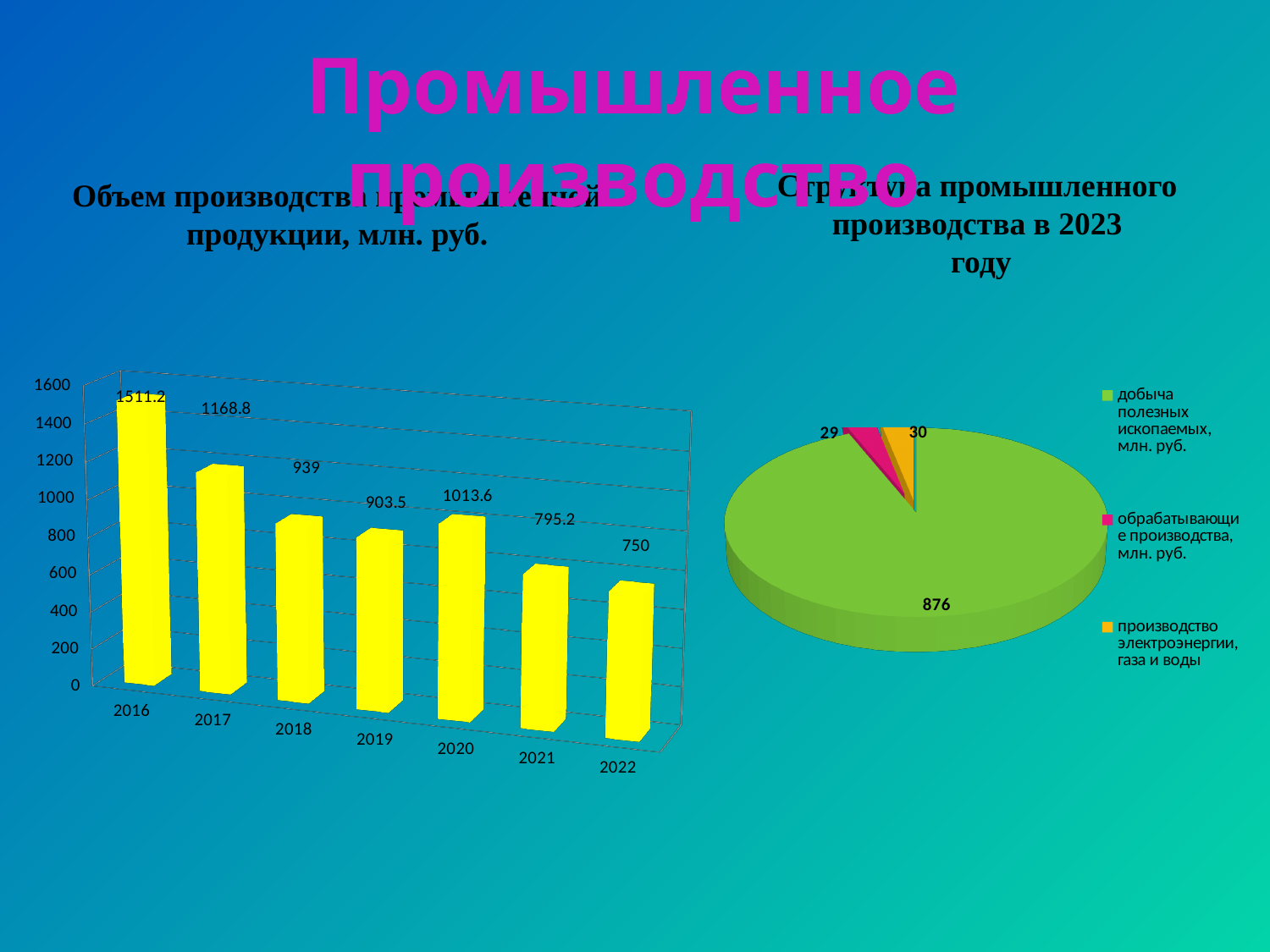
In the bar chart 'Объем производства промышленной продукции, млн. руб.', what is the value for 2016? 1511.2 In the bar chart on the left, which year has the larger value, 2018 or 2019? 2018 In the bar chart on the left, do the values generally rise or fall from 2016 to 2022? Fall In the pie chart on the right, which category has the largest slice? добыча полезных ископаемых, млн. руб. In the bar chart on the left, which year has the lowest value? 2022 In the bar chart on the left, what is the difference between the values for 2016 and 2017? 342.4 How many entries does the legend of the pie chart on the right list? 3 How many years are shown in the bar chart on the left? 7 In the bar chart 'Объем производства промышленной продукции, млн. руб.', what is the value for 2020? 1013.6 In the pie chart 'Структура промышленного производства в 2023 году', what is the value for 'добыча полезных ископаемых, млн. руб.'? 876 In the bar chart on the left, which year has the highest value? 2016 What kind of chart is the chart on the left of the slide? Bar chart